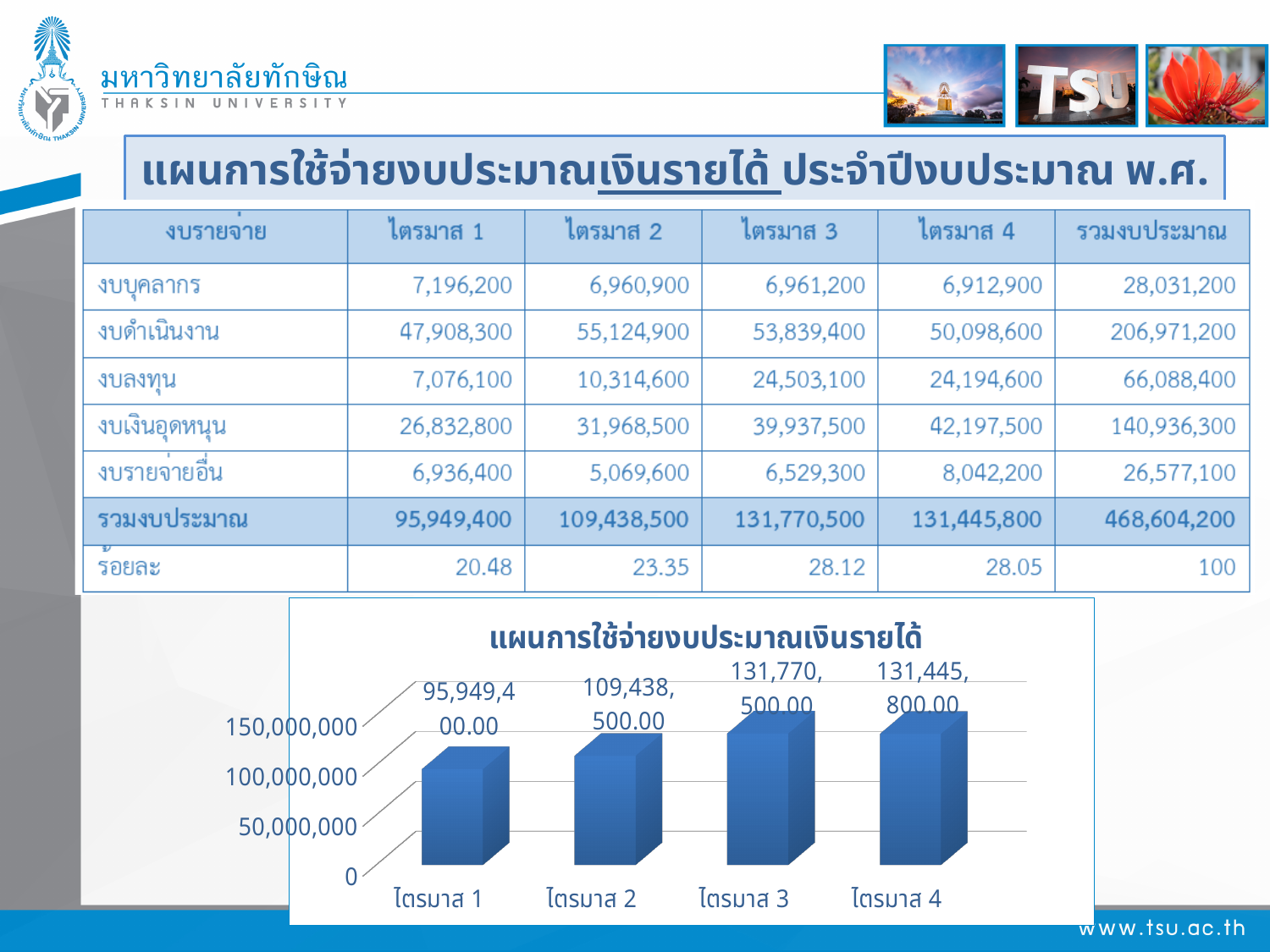
What is the value shown for ไตรมาส 4 in the chart? 131,445,800.00 What is the difference between the values for ไตรมาส 2 and ไตรมาส 1 in the chart? 13,489,100.00 Do the values rise or fall from ไตรมาส 1 to ไตรมาส 3? rise Is the value for ไตรมาส 1 greater or less than 50,000,000? greater What is the title of the chart? แผนการใช้จ่ายงบประมาณเงินรายได้ How many categories (quarters) are plotted in the chart? 4 What is the value shown for ไตรมาส 1 in the chart? 95,949,400.00 Which is larger in the chart, the value for ไตรมาส 2 or ไตรมาส 1? ไตรมาส 2 What type of chart is shown on the slide? Bar chart What is the value shown for ไตรมาส 2 in the chart? 109,438,500.00 Which quarter has the highest value in the chart? ไตรมาส 3 Which quarter has the lowest value in the chart? ไตรมาส 1